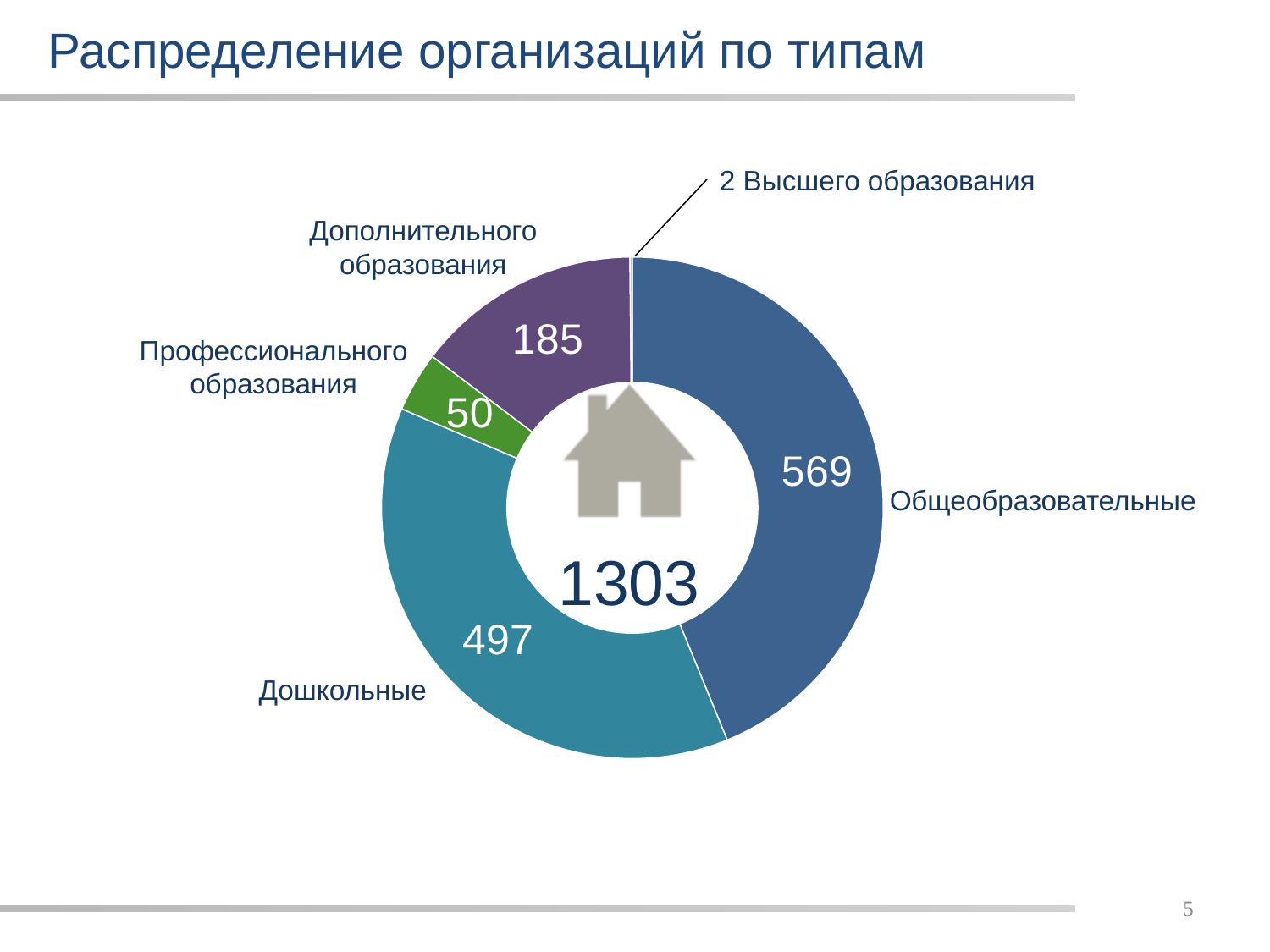
Which is larger: Дополнительного образования or Профессионального образования? Дополнительного образования What value is shown for Дополнительного образования? 185 What value is shown for Профессионального образования? 50 What total number is shown in the centre of the chart? 1303 What value is shown for the Дошкольные segment? 497 How many categories does the chart show? 5 Which category has the smallest number of organisations? Высшего образования What is the difference between the Общеобразовательные and Дошкольные values? 72 How many organisations of Высшего образования are shown? 2 How many organisations are in the Общеобразовательные category? 569 Which category has the largest number of organisations? Общеобразовательные What kind of chart is shown on the slide? doughnut chart